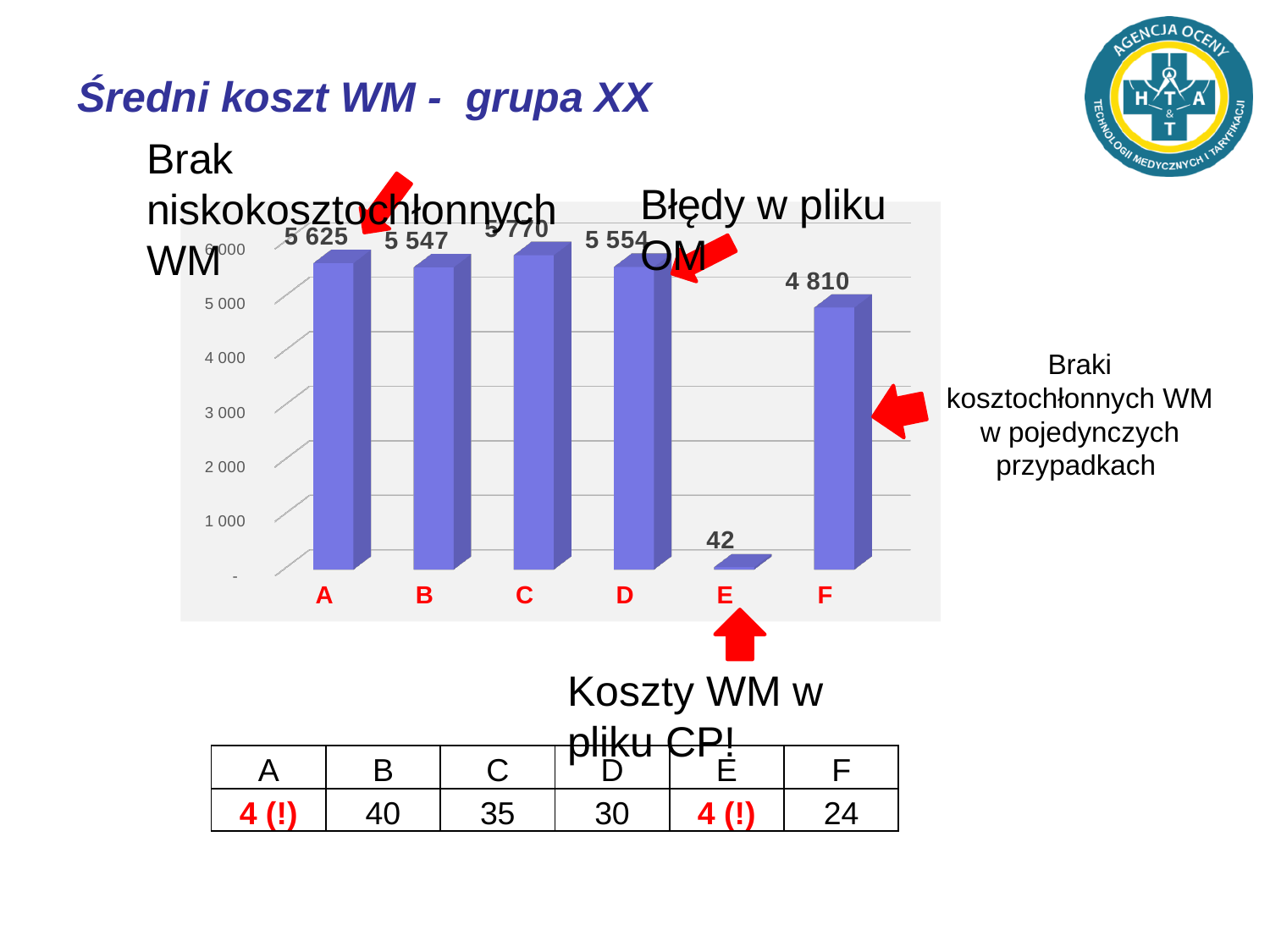
Is the value for F greater or less than 5 000? less What is the value for category A? 5 625 Which category has the highest value? C What is the value for category E? 42 What is the value for category C? 5 770 Which category has the lowest value? E What is the difference between the values for C and F? 960 What kind of chart is shown on the slide? bar chart Which is larger, the value for B or the value for D? D What is the difference between the values for A and B? 78 How many categories are shown on the x axis? 6 What is the value for category F? 4 810